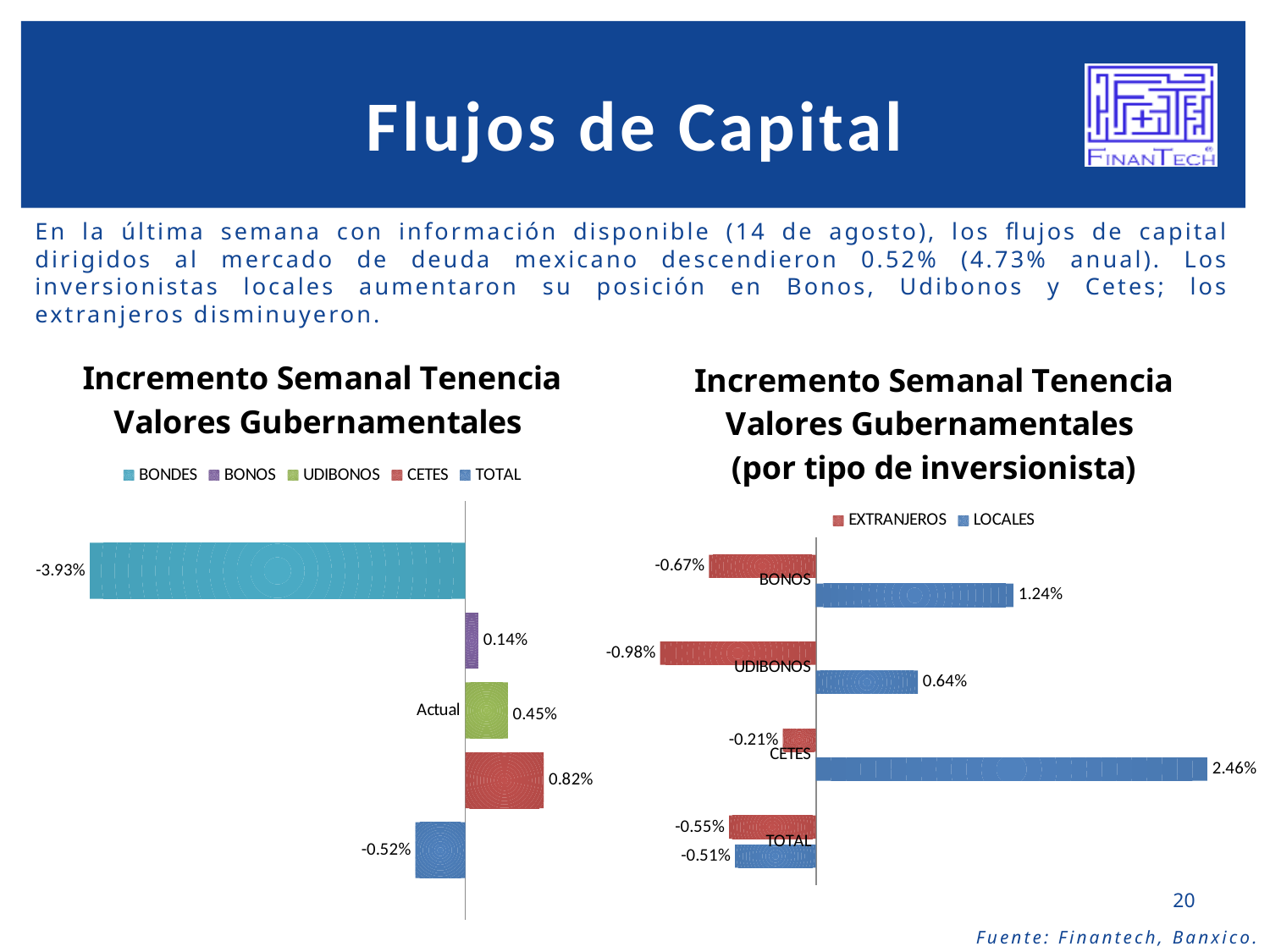
What kind of chart is the right chart (por tipo de inversionista)? Bar chart In the left chart (Incremento Semanal Tenencia Valores Gubernamentales), how many series does the legend list? 5 In the left chart (Incremento Semanal Tenencia Valores Gubernamentales), what is the value for CETES? 0.82% In the left chart (Incremento Semanal Tenencia Valores Gubernamentales), which series has the highest value? CETES In the right chart (por tipo de inversionista), what is the EXTRANJEROS value for UDIBONOS? -0.98% In the right chart (por tipo de inversionista), which category has the lowest EXTRANJEROS value? UDIBONOS In the left chart (Incremento Semanal Tenencia Valores Gubernamentales), what is the difference between the CETES value and the UDIBONOS value? 0.37% In the right chart (por tipo de inversionista), what is the LOCALES value for CETES? 2.46% In the left chart (Incremento Semanal Tenencia Valores Gubernamentales), which series has the lowest value? BONDES In the right chart (por tipo de inversionista), which category has the highest LOCALES value? CETES In the left chart (Incremento Semanal Tenencia Valores Gubernamentales), what is the value for BONDES? -3.93% In the right chart (por tipo de inversionista), how many categories are shown? 4